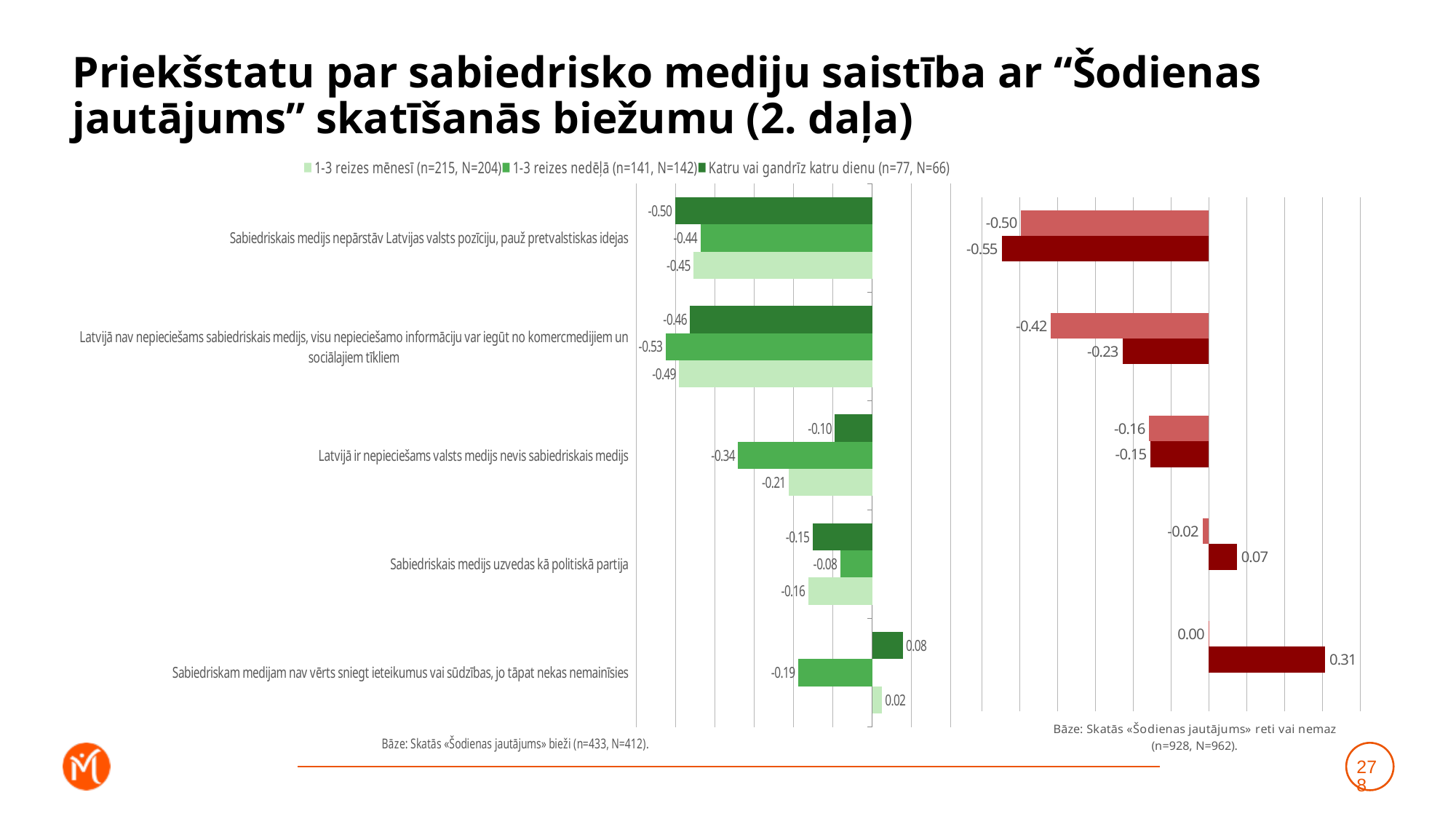
In the left (green) chart, what is the value for '1-3 reizes nedēļā' on 'Latvijā ir nepieciešams valsts medijs nevis sabiedriskais medijs'? -0.34 How many series does the legend of the left (green) chart list? 3 In the right (red) chart, what is the value of the lighter red bar for 'Latvijā nav nepieciešams sabiedriskais medijs, visu nepieciešamo informāciju var iegūt no komercmedijiem un sociālajiem tīkliem'? -0.42 In the left (green) chart, which statement has the lowest value for '1-3 reizes nedēļā'? Latvijā nav nepieciešams sabiedriskais medijs, visu nepieciešamo informāciju var iegūt no komercmedijiem un sociālajiem tīkliem In the left (green) chart, what is the difference between the '1-3 reizes nedēļā' and 'Katru vai gandrīz katru dienu' values for 'Latvijā ir nepieciešams valsts medijs nevis sabiedriskais medijs'? 0.24 In the right (red) chart, what is the value of the dark red bar for 'Sabiedriskam medijam nav vērts sniegt ieteikumus vai sūdzības, jo tāpat nekas nemainīsies'? 0.31 In the left (green) chart, what is the value for '1-3 reizes mēnesī' on 'Sabiedriskam medijam nav vērts sniegt ieteikumus vai sūdzības, jo tāpat nekas nemainīsies'? 0.02 In the left (green) chart, which statement has the highest value for 'Katru vai gandrīz katru dienu'? Sabiedriskam medijam nav vērts sniegt ieteikumus vai sūdzības, jo tāpat nekas nemainīsies What kind of chart is the left (green) chart? Bar chart How many statement categories are shown in the left (green) chart? 5 In the left (green) chart, for 'Sabiedriskais medijs uzvedas kā politiskā partija', which is larger: the '1-3 reizes nedēļā' value or the '1-3 reizes mēnesī' value? 1-3 reizes nedēļā In the left (green) chart, what is the value for 'Katru vai gandrīz katru dienu' on 'Sabiedriskais medijs nepārstāv Latvijas valsts pozīciju, pauž pretvalstiskas idejas'? -0.50